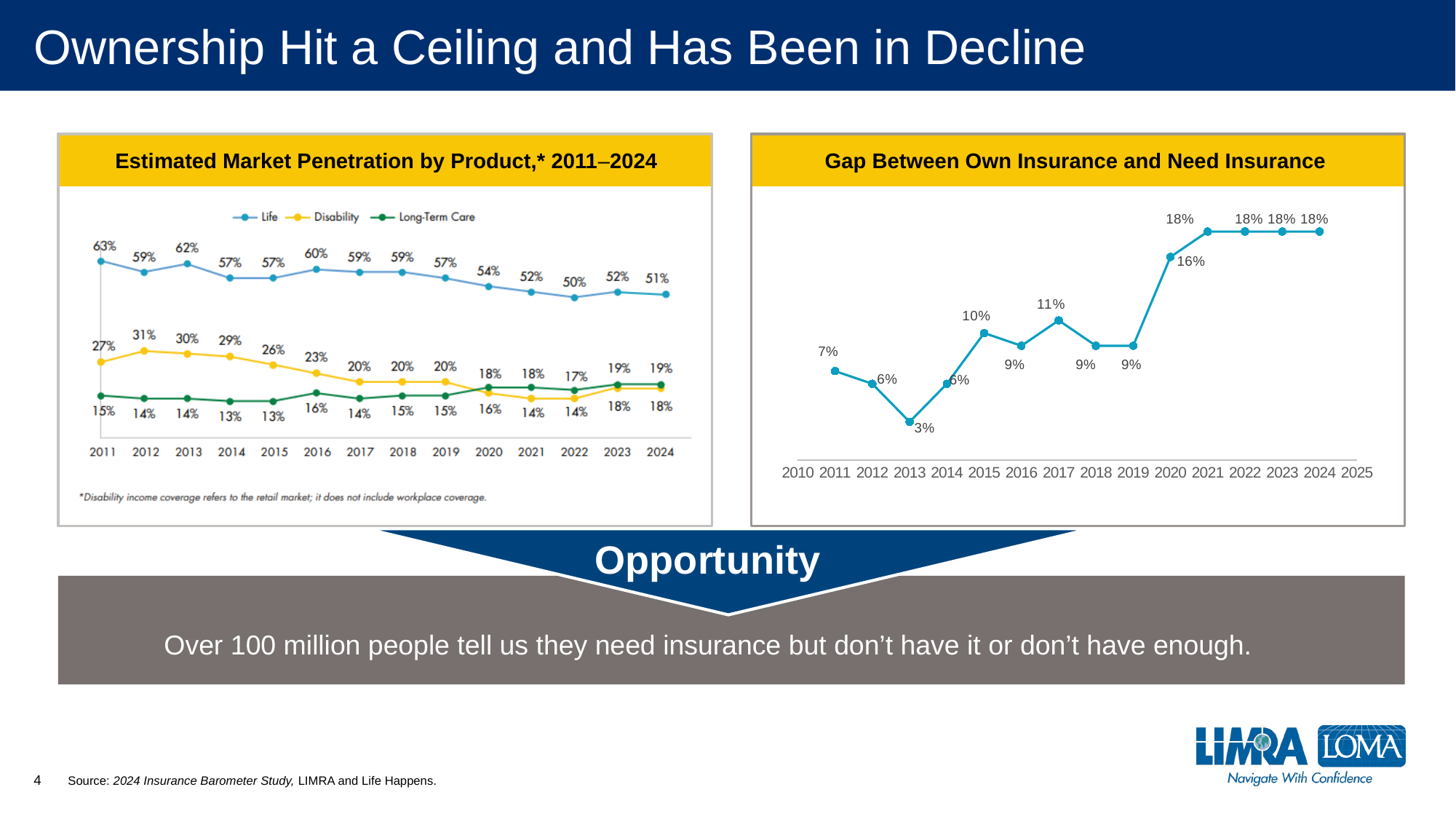
What kind of chart is the 'Gap Between Own Insurance and Need Insurance' chart? line chart In the 'Gap Between Own Insurance and Need Insurance' chart, what is the value for 2013? 3% In the 'Gap Between Own Insurance and Need Insurance' chart, what is the value for 2020? 16% In the 'Gap Between Own Insurance and Need Insurance' chart, how many data points are plotted? 14 In the 'Estimated Market Penetration by Product' chart, what is the Disability value for 2012? 31% In the 'Estimated Market Penetration by Product' chart, what is the Long-Term Care value for 2024? 18% In the 'Estimated Market Penetration by Product' chart, does the Life series generally rise or fall from 2011 to 2024? fall How many series does the legend of the 'Estimated Market Penetration by Product' chart list? 3 In the 'Gap Between Own Insurance and Need Insurance' chart, which is larger, the value for 2017 or the value for 2015? 2017 In the 'Estimated Market Penetration by Product' chart, in which year is the Life series lowest? 2022 In the 'Estimated Market Penetration by Product' chart, what is the Life value for 2011? 63% In the 'Estimated Market Penetration by Product' chart, what is the difference between the Life values for 2011 and 2024? 12%